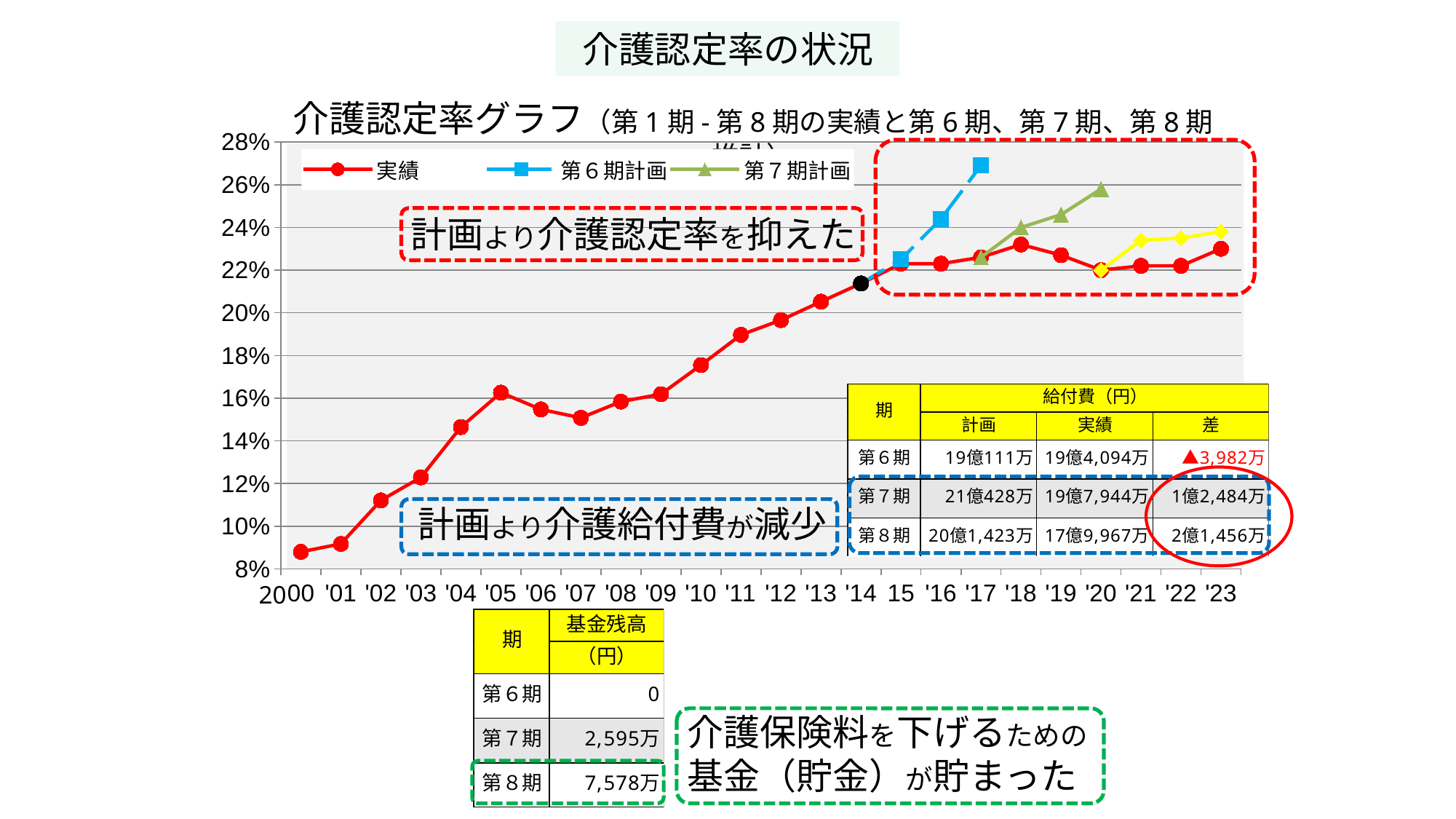
In '17, which is higher: 第6期計画 or 実績? 第6期計画 What kind of chart is shown on the slide? line chart How many year labels are shown on the x axis of the chart? 24 Which series is drawn in red with circle markers? 実績 In which year is the 実績 value lowest? 2000 Is the 実績 value for '14 greater or less than 20%? greater Does the 第6期計画 line rise or fall from '15 to '17? rise Does the 実績 line rise or fall from 2000 to '14? rise How many series does the chart legend list? 3 Is the 実績 value for 2000 greater or less than 10%? less Is the 第7期計画 value for '20 greater or less than 24%? greater